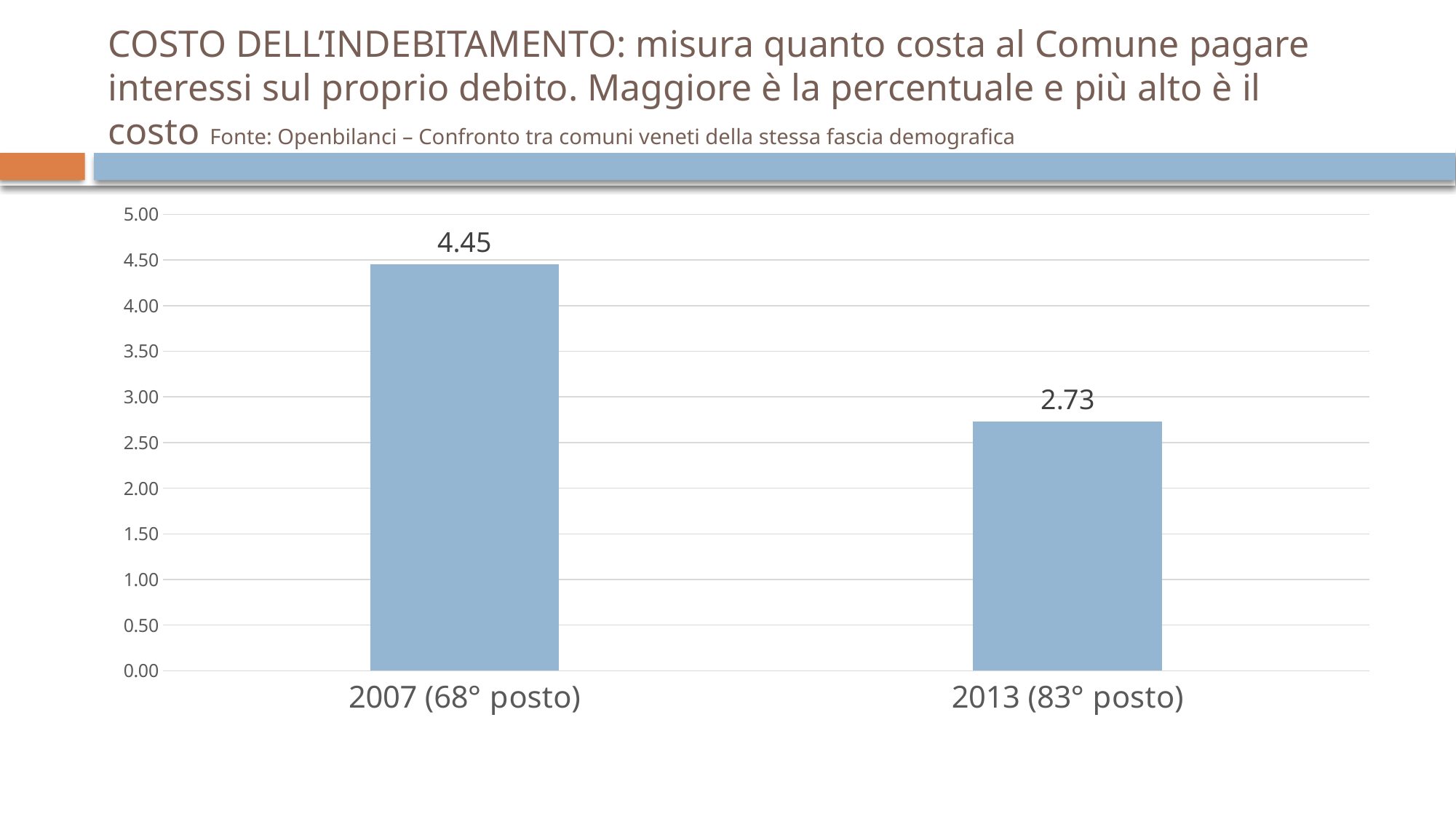
Is the value for 2007 (68° posto) greater or less than 4.00? greater What kind of chart is shown on the slide? bar chart Which category has the lowest value? 2013 (83° posto) What is the difference between the values for 2007 (68° posto) and 2013 (83° posto)? 1.72 Which category has the highest value? 2007 (68° posto) Is the value for 2013 (83° posto) greater or less than 3.00? less Do the values rise or fall from 2007 to 2013? fall What is the value for 2007 (68° posto)? 4.45 What is the highest tick value shown on the y axis? 5.00 How many categories are shown on the x axis? 2 What is the value for 2013 (83° posto)? 2.73 Which is larger, the value for 2007 (68° posto) or the value for 2013 (83° posto)? 2007 (68° posto)